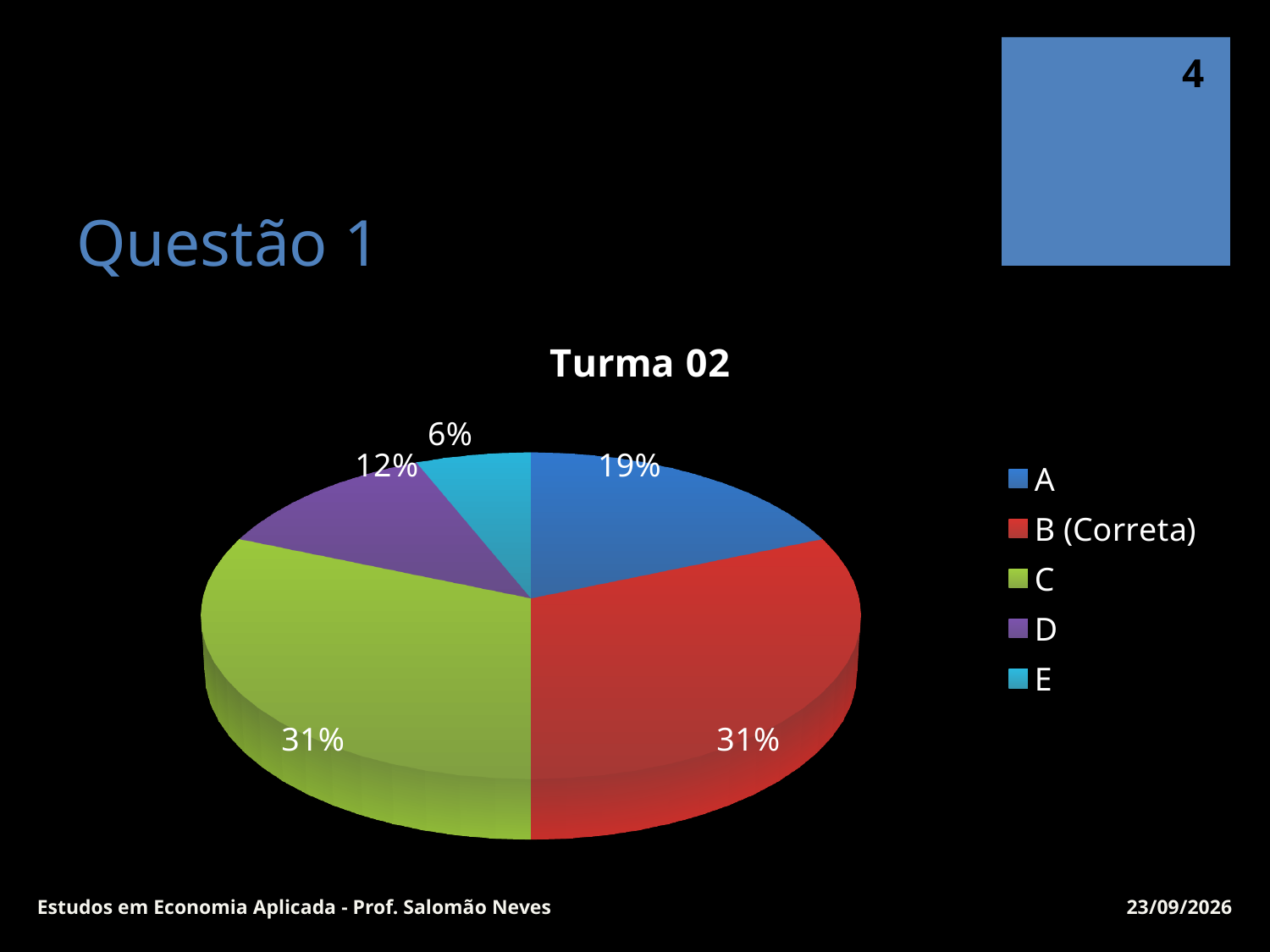
What is the title of the chart? Turma 02 How many slices does the pie chart have? 5 What percentage of the pie does slice B (Correta) represent? 31% How many entries does the legend list? 5 What percentage of the pie does slice D represent? 12% What is the difference in percentage points between slice C and slice A? 12 What kind of chart is shown on the slide? pie chart Which legend entry is marked as the correct answer? B (Correta) Which slice is larger, A or D? A What percentage of the pie does slice A represent? 19% What percentage of the pie does slice E represent? 6% Which slice has the smallest share of the pie? E